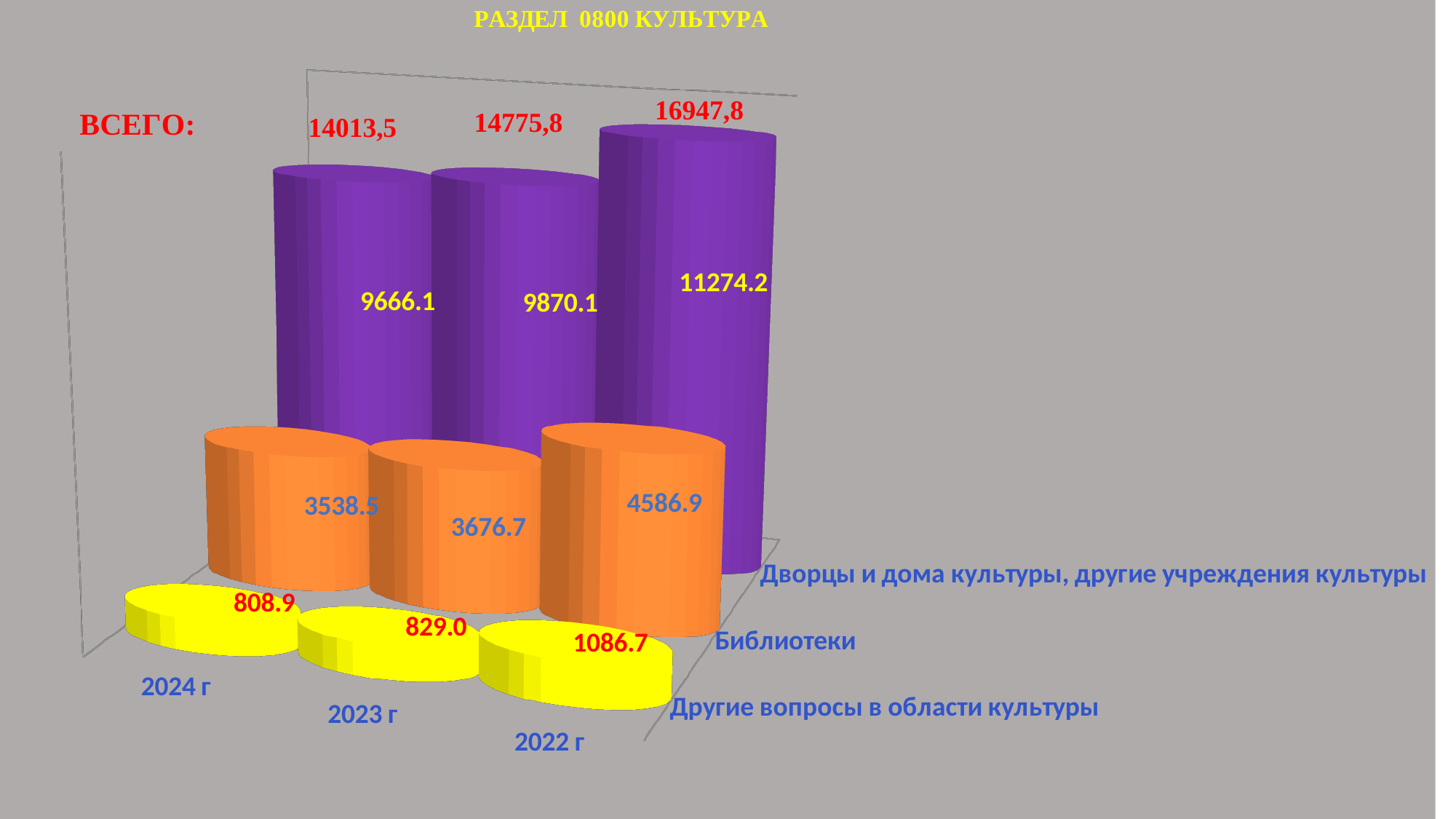
What kind of chart is shown on the slide? 3D bar chart What is the value for Дворцы и дома культуры, другие учреждения культуры in 2022 г? 11274.2 How many series does the chart show? 3 What is the difference between the Библиотеки values for 2022 г and 2024 г? 1048.4 Which year has the highest value for Библиотеки? 2022 г What is the ВСЕГО (total) shown for 2023 г? 14775,8 What is the value for Другие вопросы в области культуры in 2024 г? 808.9 What colour are the bars for Библиотеки? Orange How many years are shown on the chart? 3 Which year has the lowest value for Дворцы и дома культуры, другие учреждения культуры? 2024 г Which is larger: Другие вопросы в области культуры in 2023 г or in 2022 г? 2022 г What is the value for Библиотеки in 2023 г? 3676.7